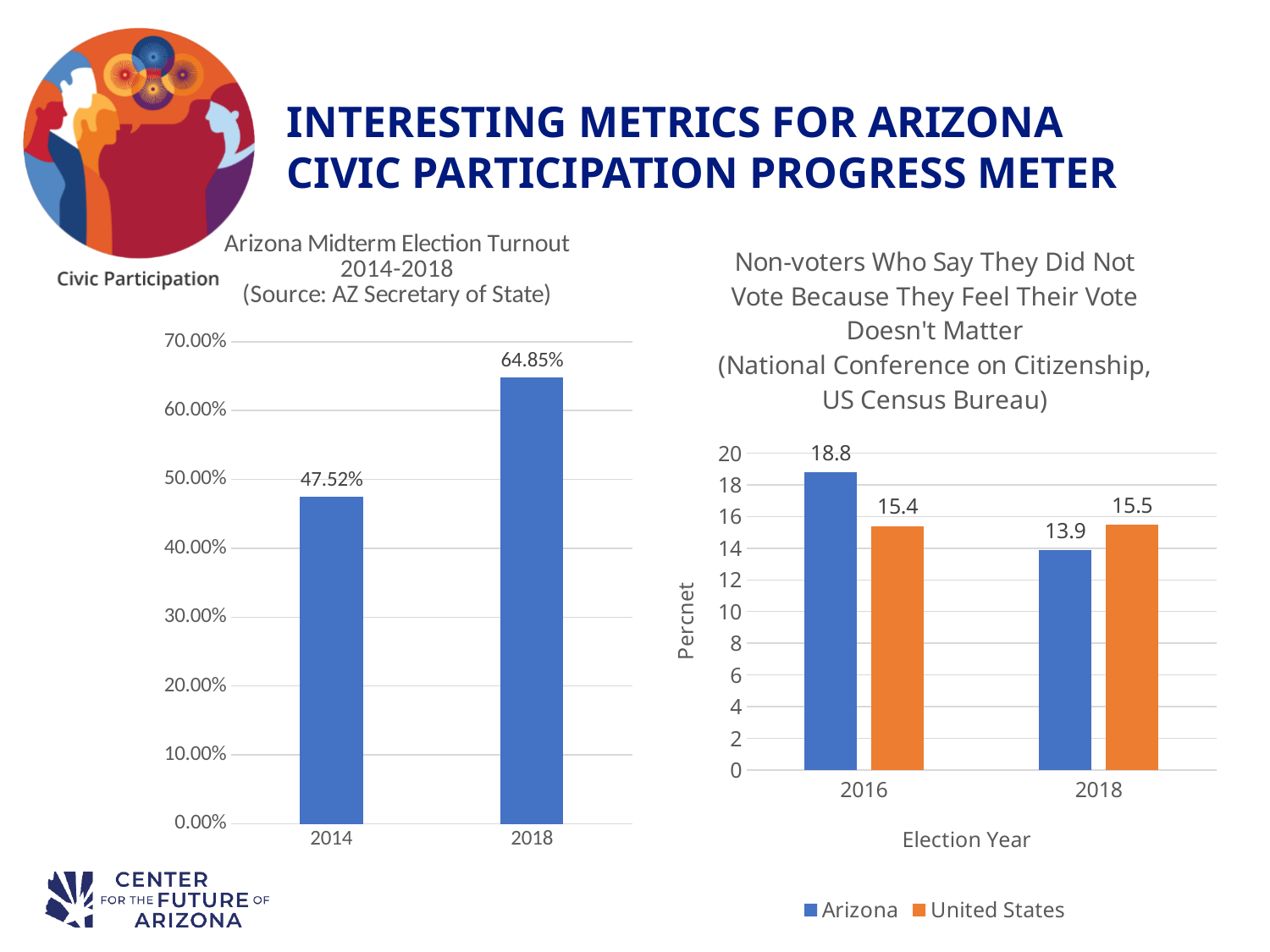
In the Arizona Midterm Election Turnout chart, what was the turnout in 2018? 64.85% In the Arizona Midterm Election Turnout chart, how many years are plotted? 2 In the Arizona Midterm Election Turnout chart, which year had the higher turnout? 2018 In the Arizona Midterm Election Turnout chart, by how many percentage points did turnout increase from 2014 to 2018? 17.33 In the Arizona Midterm Election Turnout chart, what was the turnout in 2014? 47.52% In the Non-voters chart on the right, which is larger in 2018: Arizona or United States? United States In the Non-voters chart on the right, what is the value for the United States in 2018? 15.5 In the Non-voters chart on the right, how many series does the legend list? 2 In the Non-voters chart on the right, does the Arizona value rise or fall from 2016 to 2018? Fall In the Non-voters chart on the right, what is the difference between Arizona and the United States in 2016? 3.4 In the Non-voters chart on the right, what is the value for Arizona in 2016? 18.8 What type of chart is the Arizona Midterm Election Turnout chart? Bar chart